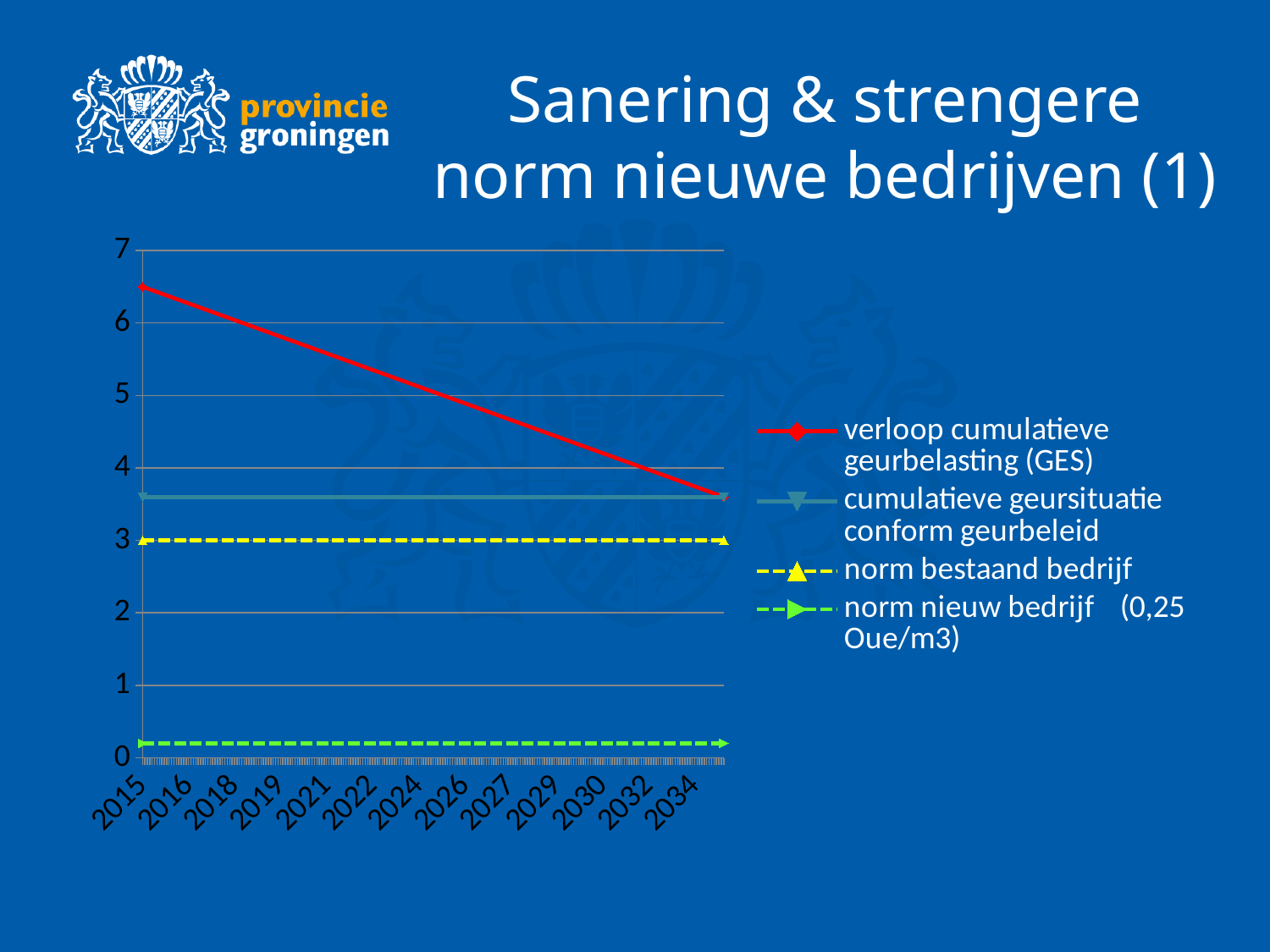
What value does the 'norm bestaand bedrijf' line sit at on the y axis? 3 What colour is the 'verloop cumulatieve geurbelasting (GES)' line? red Does the 'norm bestaand bedrijf' line rise, fall or stay constant across the years? stay constant Is the value of 'verloop cumulatieve geurbelasting (GES)' in 2034 greater or less than 4? less What kind of chart is shown on the slide? line chart In 2015, which is higher: 'verloop cumulatieve geurbelasting (GES)' or 'cumulatieve geursituatie conform geurbeleid'? verloop cumulatieve geurbelasting (GES) Which is higher on the chart, 'norm bestaand bedrijf' or 'norm nieuw bedrijf'? norm bestaand bedrijf Does the 'verloop cumulatieve geurbelasting (GES)' line rise or fall from 2015 to 2034? fall How many year labels are shown on the x axis? 13 Is the value of 'verloop cumulatieve geurbelasting (GES)' in 2015 greater or less than 6? greater According to the legend, what value is given for 'norm nieuw bedrijf'? 0,25 Oue/m3 How many series does the legend list? 4